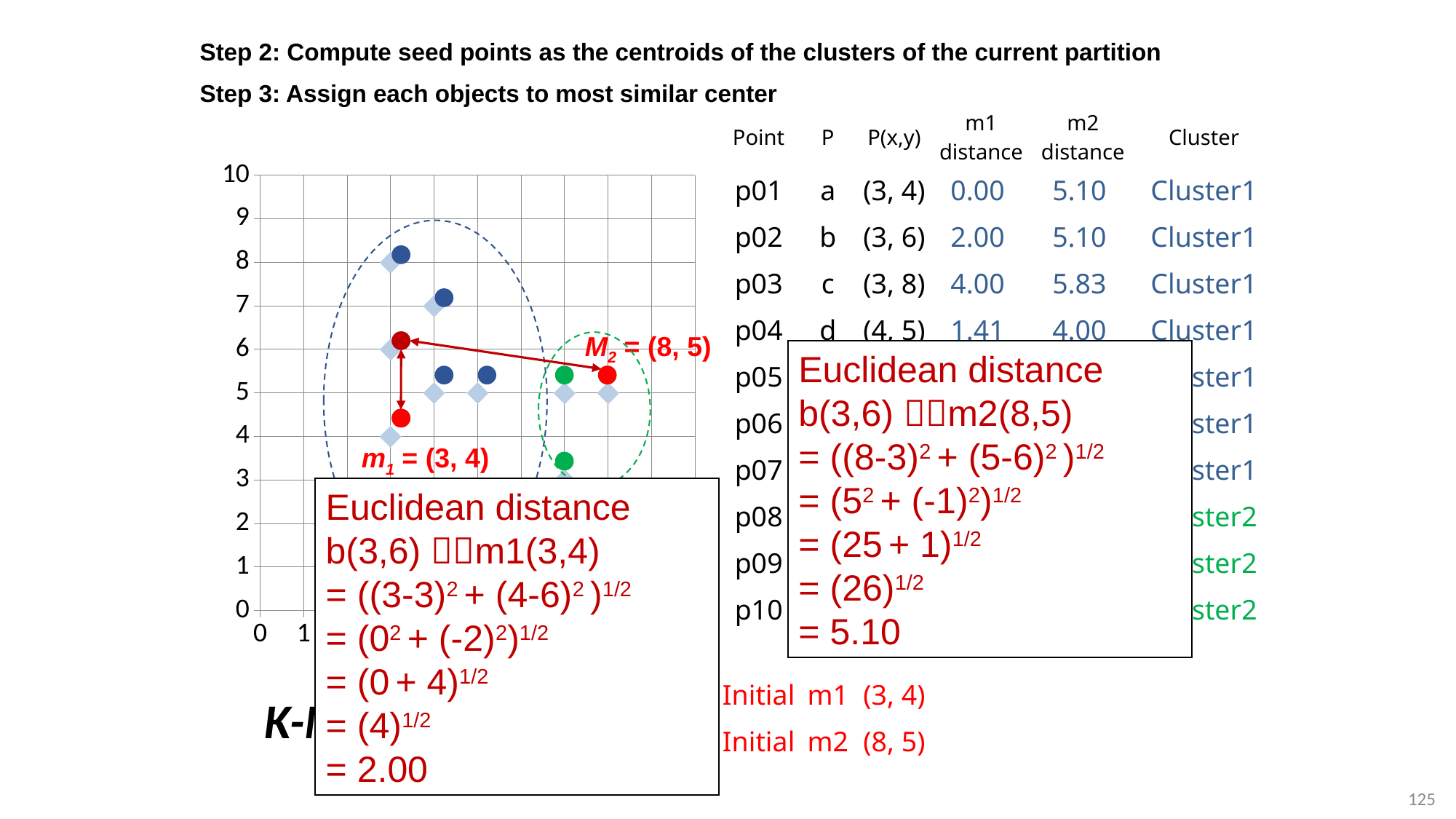
What is the highest value shown on the y axis of the scatter chart? 10 Is the y value of the point labelled M2 greater or less than 6? less In the table, what is the difference between the m2 distance and the m1 distance for point c (p03)? 1.83 In the table, what is the m1 distance for point b (p02)? 2.00 What coordinates are given for m1 on the scatter chart? (3, 4) In the table, what are the P(x,y) coordinates of point d (p04)? (4, 5) Which cluster is point d (p04) assigned to in the table? Cluster1 In the table, what is the m2 distance for point c (p03)? 5.83 Is the y value of the highest blue point on the scatter chart greater or less than 7? greater What kind of chart is shown on the left of the slide? scatter chart In the table, which is larger for point a (p01): the m1 distance or the m2 distance? m2 distance What coordinates are given for M2 on the scatter chart? (8, 5)